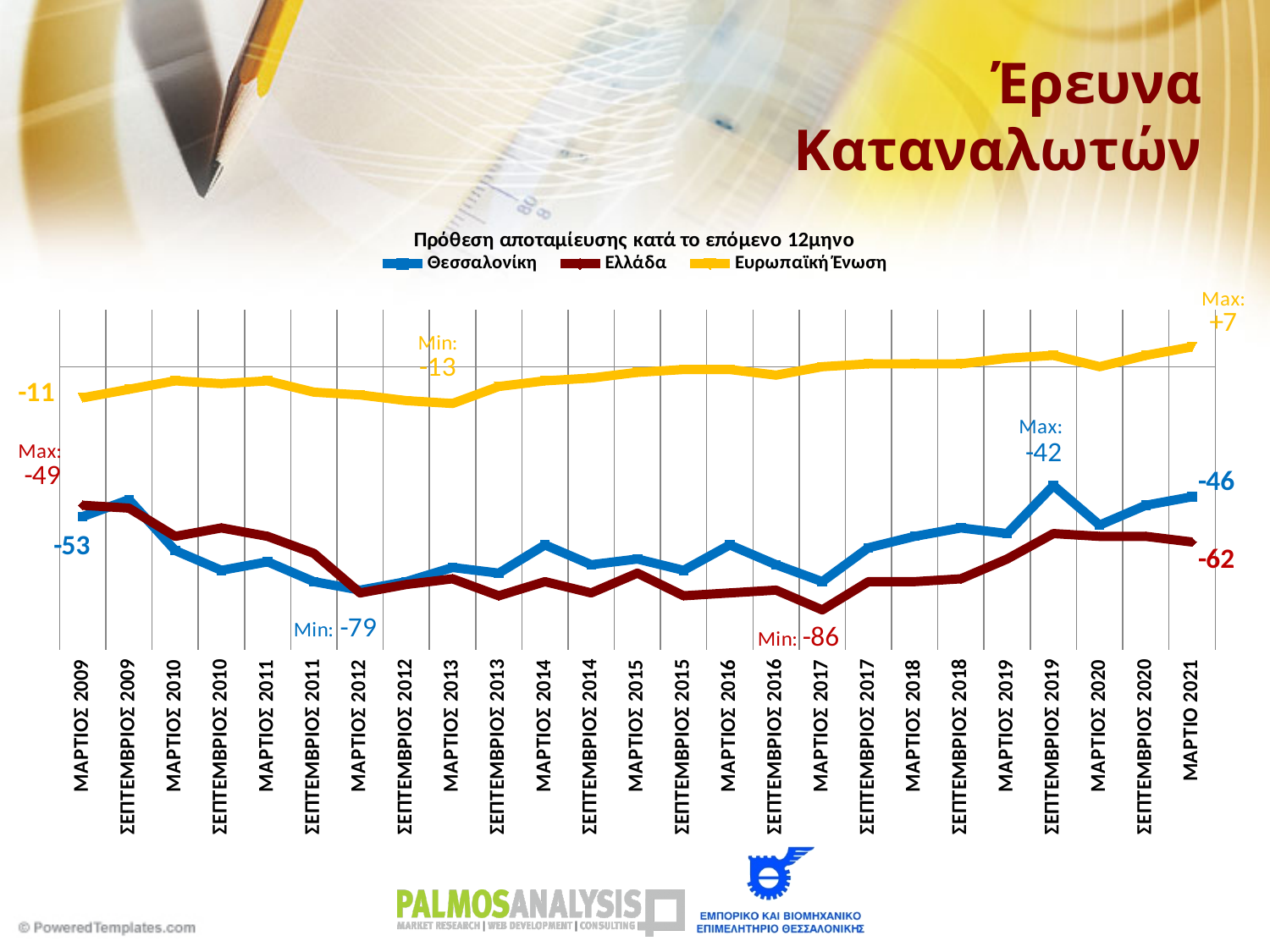
What is the minimum value of the Ελλάδα series, and when does it occur? -86, ΜΑΡΤΙΟΣ 2017 What is the minimum value of the Ευρωπαϊκή Ένωση series? -13 What is the value for Θεσσαλονίκη in ΜΑΡΤΙΟ 2021? -46 In ΜΑΡΤΙΟΣ 2009, which is higher: Θεσσαλονίκη or Ελλάδα? Ελλάδα What is the difference between the Θεσσαλονίκη and Ελλάδα values in ΜΑΡΤΙΟ 2021? 16 Does the Ευρωπαϊκή Ένωση series rise or fall from ΜΑΡΤΙΟΣ 2013 to ΜΑΡΤΙΟ 2021? Rise What type of chart is shown on the slide? Line chart How many time points are shown on the x axis? 25 What is the value for Ευρωπαϊκή Ένωση in ΜΑΡΤΙΟΣ 2009? -11 How many series does the legend list? 3 What is the maximum value of the Θεσσαλονίκη series, and when does it occur? -42, ΣΕΠΤΕΜΒΡΙΟΣ 2019 What is the value for Ελλάδα in ΜΑΡΤΙΟ 2021? -62